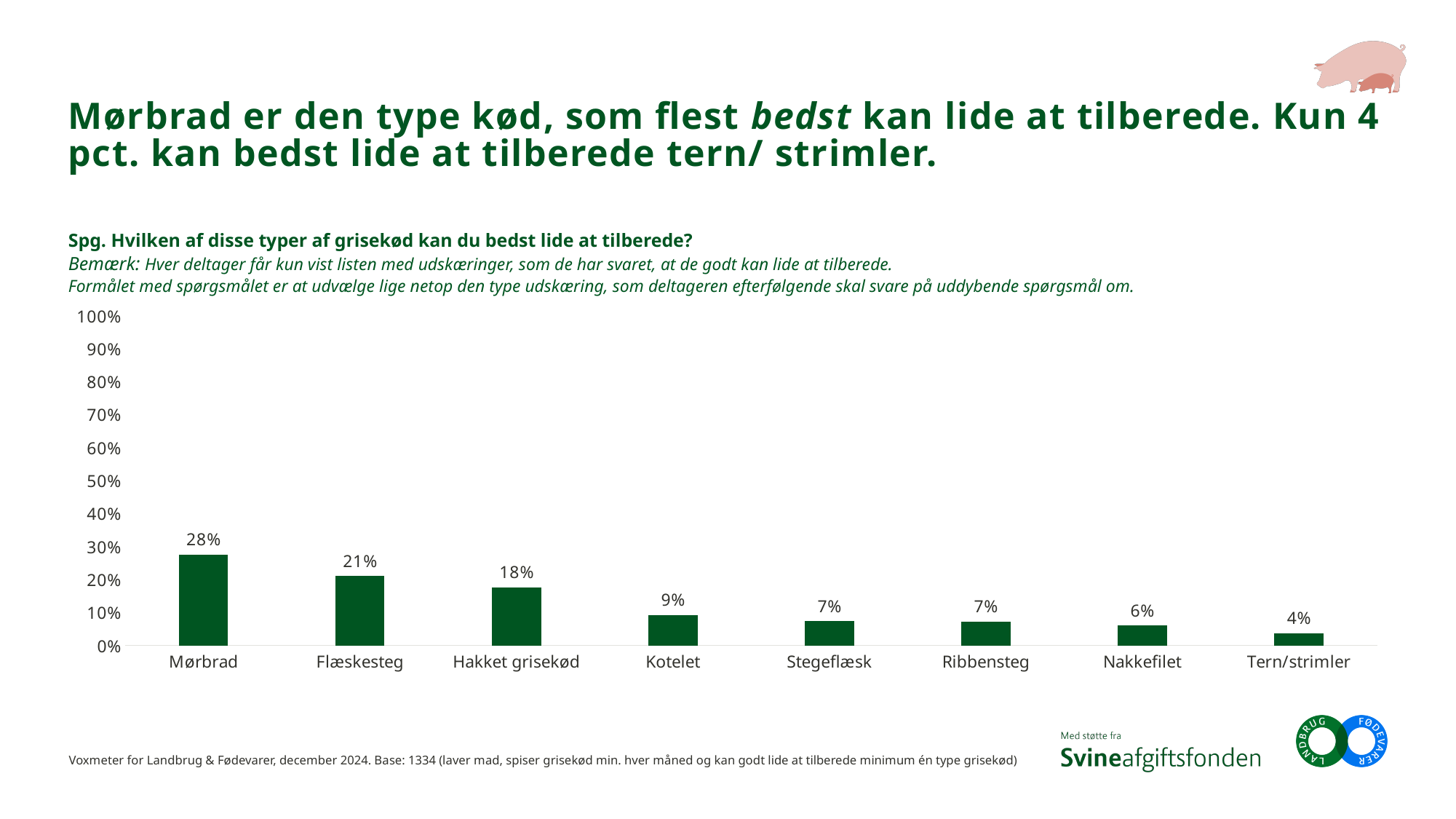
What is the difference between the values for Mørbrad and Flæskesteg? 7% What is the value for Hakket grisekød? 18% Do the values rise or fall from left to right along the x axis? fall What is the value for Mørbrad? 28% What is the value for Nakkefilet? 6% What kind of chart is shown on the slide? bar chart Which category has the lowest value? Tern/strimler How many categories are shown on the x axis? 8 Which is larger, the value for Flæskesteg or the value for Hakket grisekød? Flæskesteg Is the value for Mørbrad greater or less than 20%? greater What is the difference between the values for Kotelet and Tern/strimler? 5% Which category has the highest value? Mørbrad